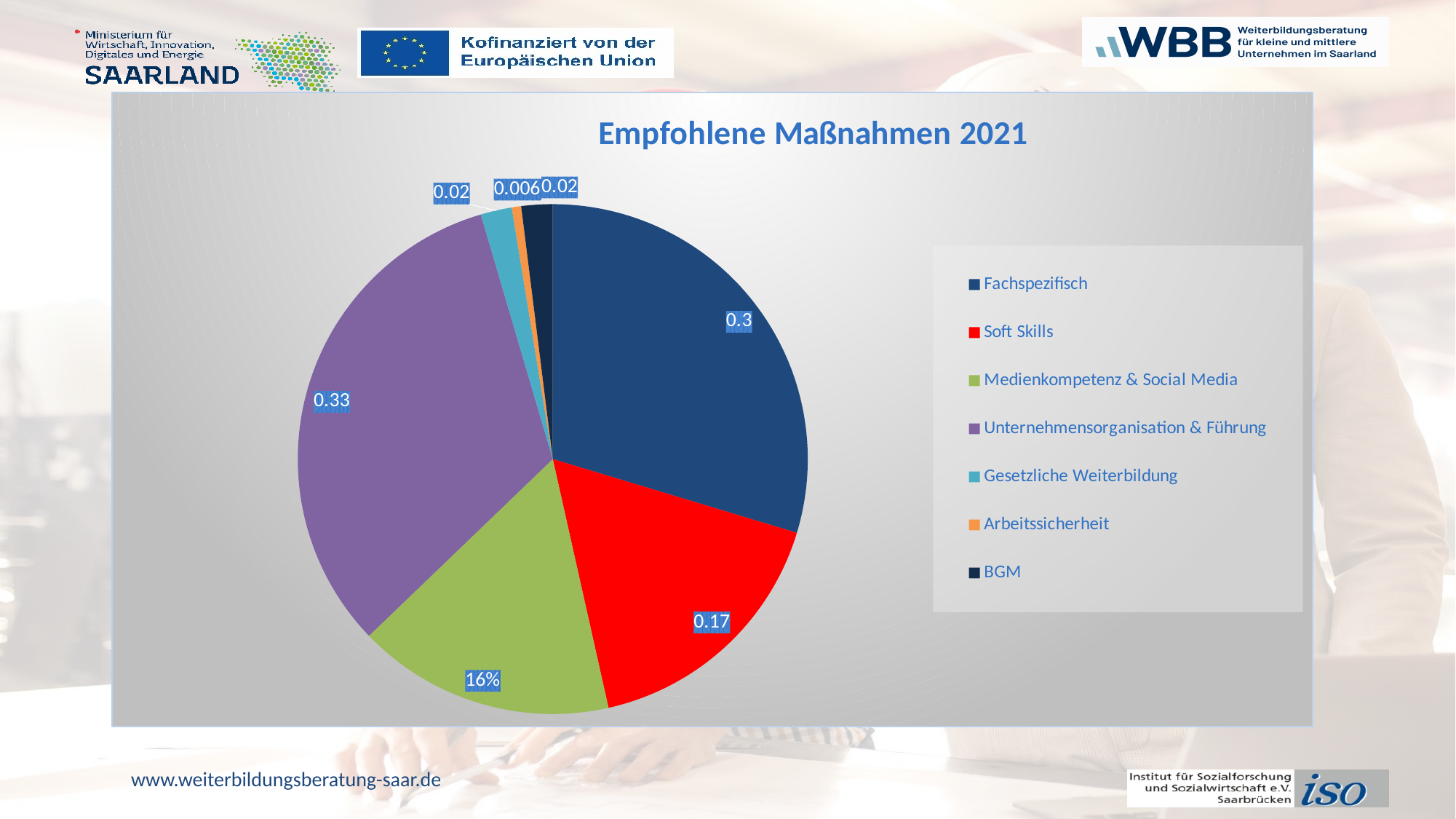
What kind of chart is shown on the slide? pie chart What is the value shown for Fachspezifisch? 0.3 How many categories does the pie chart have? 7 Which category has the largest slice of the pie? Unternehmensorganisation & Führung What is the title of the chart? Empfohlene Maßnahmen 2021 Which is larger, the value for Fachspezifisch or the value for Soft Skills? Fachspezifisch What is the value shown for Soft Skills? 0.17 Which category has the smallest slice of the pie? Arbeitssicherheit What is the value shown for Unternehmensorganisation & Führung? 0.33 What is the value shown for Arbeitssicherheit? 0.006 What is the difference between the values for Fachspezifisch and Soft Skills? 0.13 What is the value shown for Medienkompetenz & Social Media? 16%